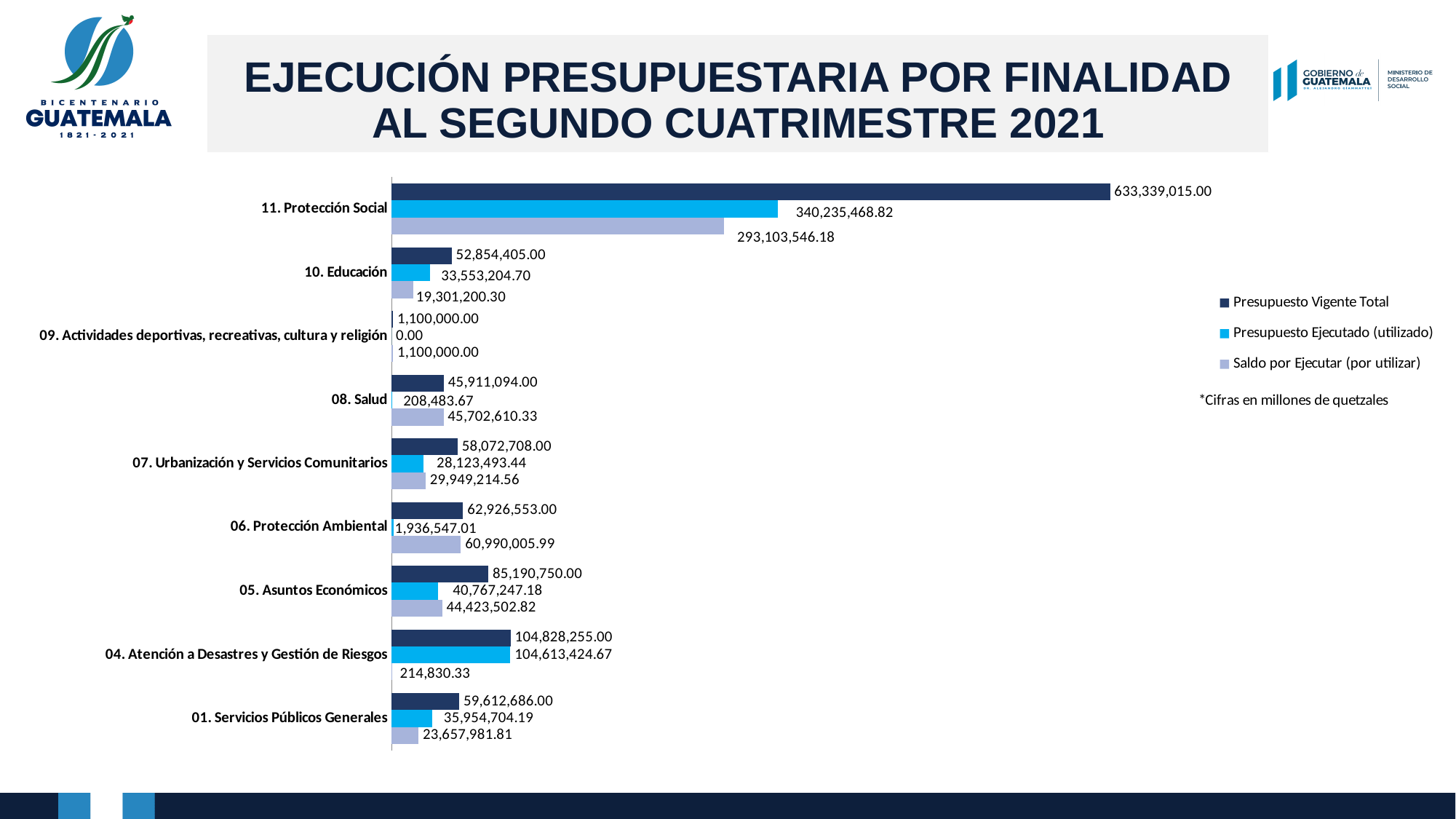
How many series does the legend list? 3 What is the difference between the Presupuesto Vigente Total and the Presupuesto Ejecutado (utilizado) for 05. Asuntos Económicos? 44,423,502.82 What is the Presupuesto Ejecutado (utilizado) for 08. Salud? 208,483.67 What is the Presupuesto Vigente Total for 11. Protección Social? 633,339,015.00 How many categories (finalidades) are plotted on the chart? 9 Which category has the lowest Presupuesto Ejecutado (utilizado)? 09. Actividades deportivas, recreativas, cultura y religión Which category has the highest Presupuesto Vigente Total? 11. Protección Social What note about the units appears below the legend? *Cifras en millones de quetzales What is the Saldo por Ejecutar (por utilizar) for 06. Protección Ambiental? 60,990,005.99 Which is larger: the Presupuesto Ejecutado (utilizado) for 10. Educación or for 01. Servicios Públicos Generales? 01. Servicios Públicos Generales What is the Presupuesto Ejecutado (utilizado) for 04. Atención a Desastres y Gestión de Riesgos? 104,613,424.67 What kind of chart is shown on the slide? Bar chart